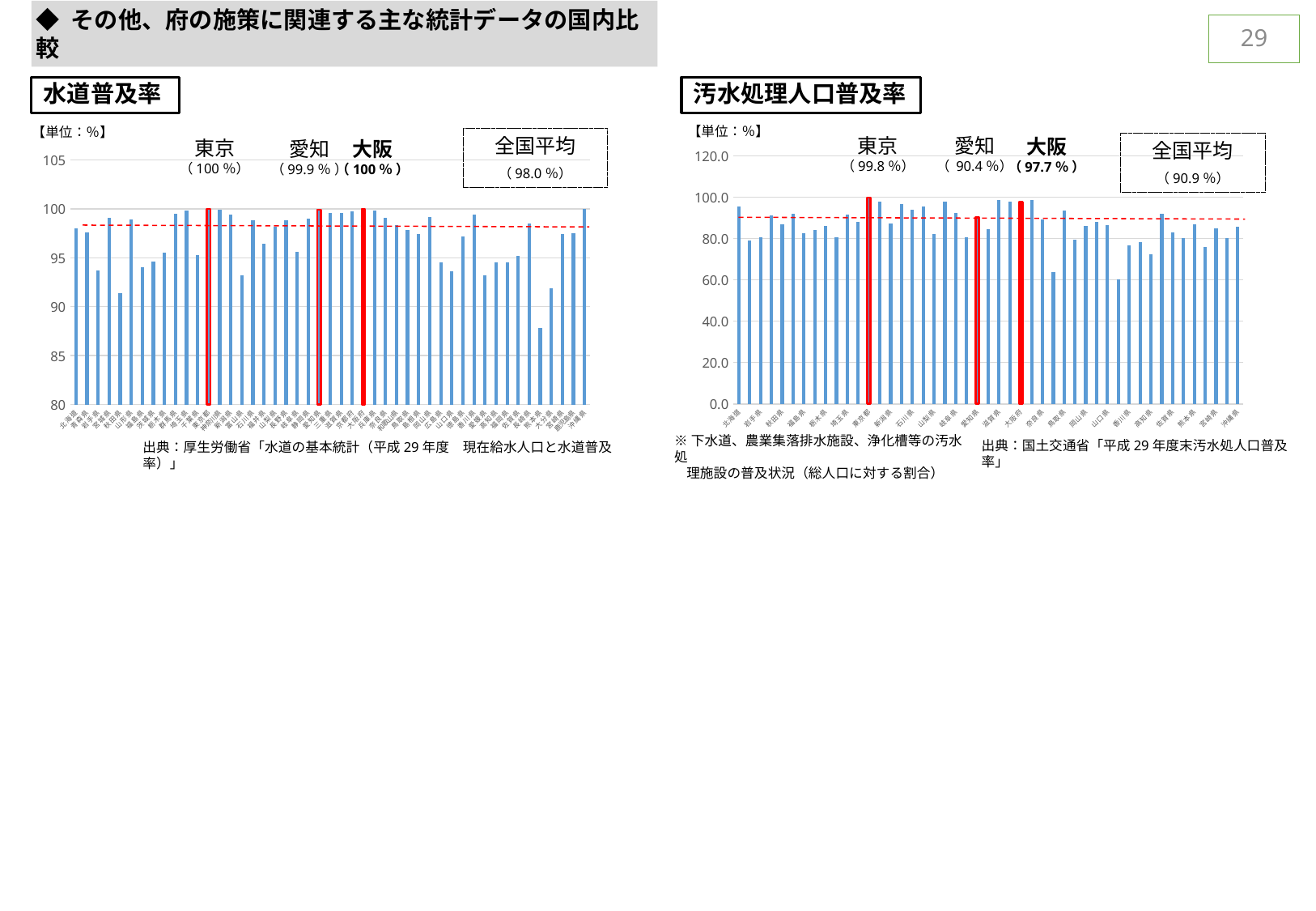
In the 水道普及率 chart, what is the value for 東京? 100 % What kind of chart is the 水道普及率 chart? bar chart In the 水道普及率 chart, what is the 全国平均 value? 98.0 % In the 汚水処理人口普及率 chart, which is larger, 大阪 or 愛知? 大阪 In the 汚水処理人口普及率 chart, what is the value for 東京? 99.8 % In the 水道普及率 chart, how much higher is 大阪 than the 全国平均? 2.0 % In the 水道普及率 chart, what is the value for 愛知? 99.9 % In the 汚水処理人口普及率 chart, what is the 全国平均 value? 90.9 % In the 汚水処理人口普及率 chart, what colour are the highlighted bars for 東京, 愛知 and 大阪? red In the 汚水処理人口普及率 chart, what is the value for 大阪? 97.7 % In the 汚水処理人口普及率 chart, how much higher is 大阪 than the 全国平均? 6.8 % In the 汚水処理人口普及率 chart, how much higher is 東京 than 愛知? 9.4 %